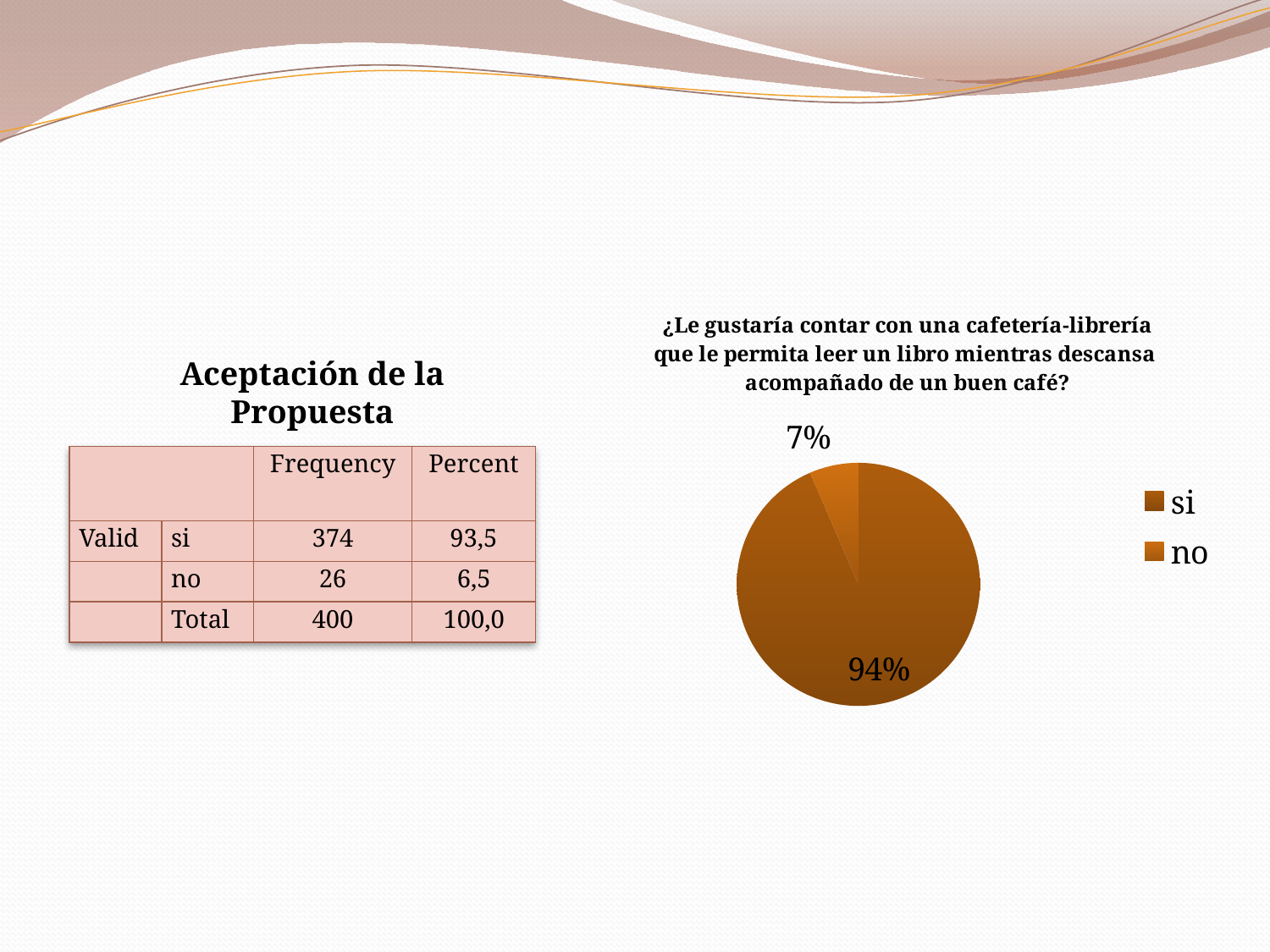
What percentage does the pie chart show for "no"? 7% Which slice is larger in the pie chart, "si" or "no"? si What are the two legend entries of the pie chart? si, no What percentage does the pie chart show for "si"? 94% How many slices does the pie chart have? 2 Which category has the smallest slice in the pie chart? no What kind of chart is shown on the slide? pie chart What share of the pie does the "si" slice represent? 94% Which category has the largest slice in the pie chart? si What is the title of the pie chart? ¿Le gustaría contar con una cafetería-librería que le permita leer un libro mientras descansa acompañado de un buen café? How many entries does the pie chart's legend list? 2